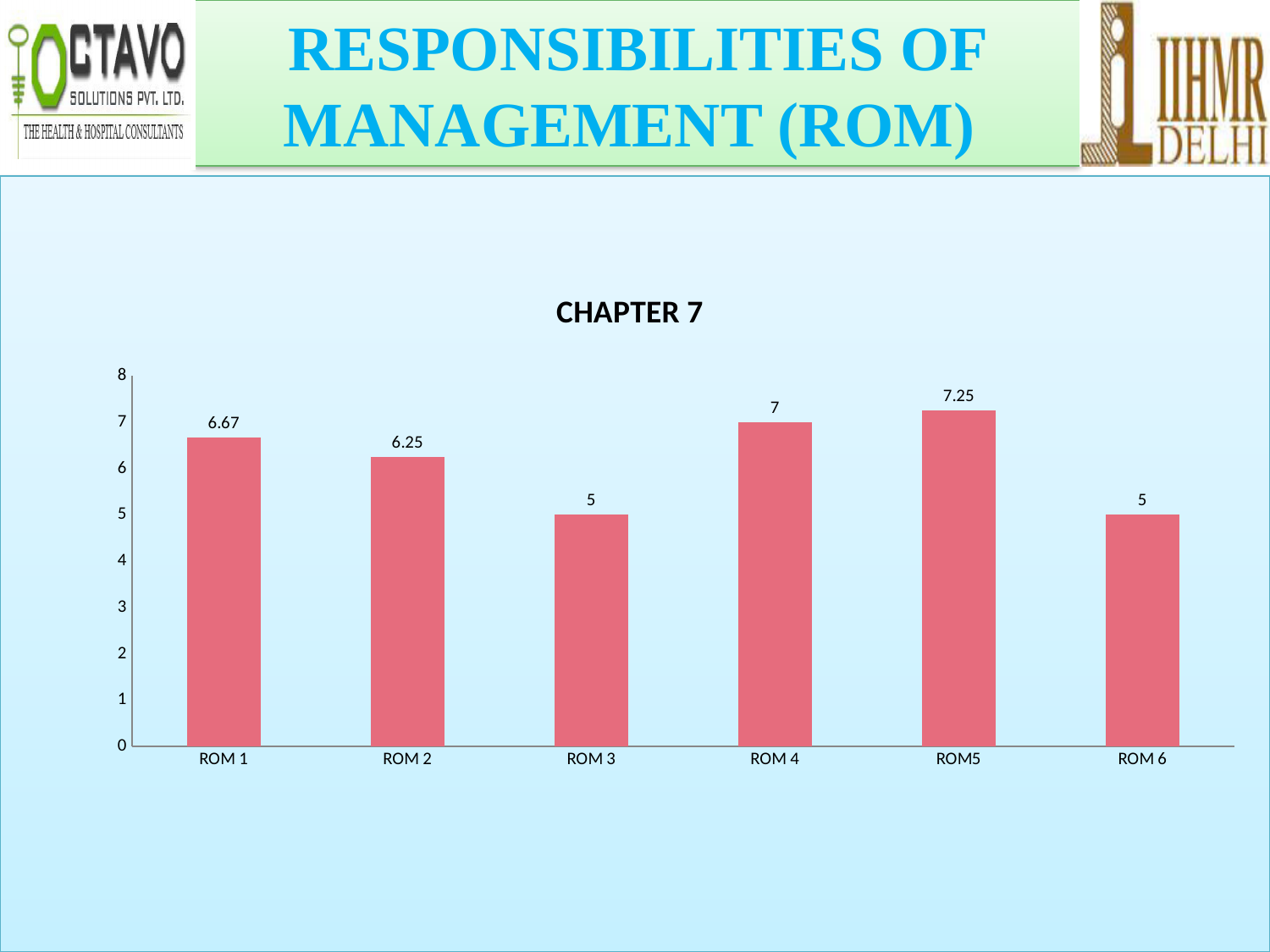
What kind of chart is shown on the slide? bar chart What is the value for ROM 2? 6.25 Is the value for ROM 2 greater or less than 6? greater What is the difference between the values for ROM 1 and ROM 2? 0.42 What is the value for ROM 1? 6.67 What is the title of the chart? CHAPTER 7 Which category has the highest value? ROM5 Which is larger, the value for ROM 1 or the value for ROM 4? ROM 4 What is the value for ROM5? 7.25 What is the value for ROM 4? 7 What is the difference between the values for ROM5 and ROM 3? 2.25 How many categories are shown on the x axis? 6